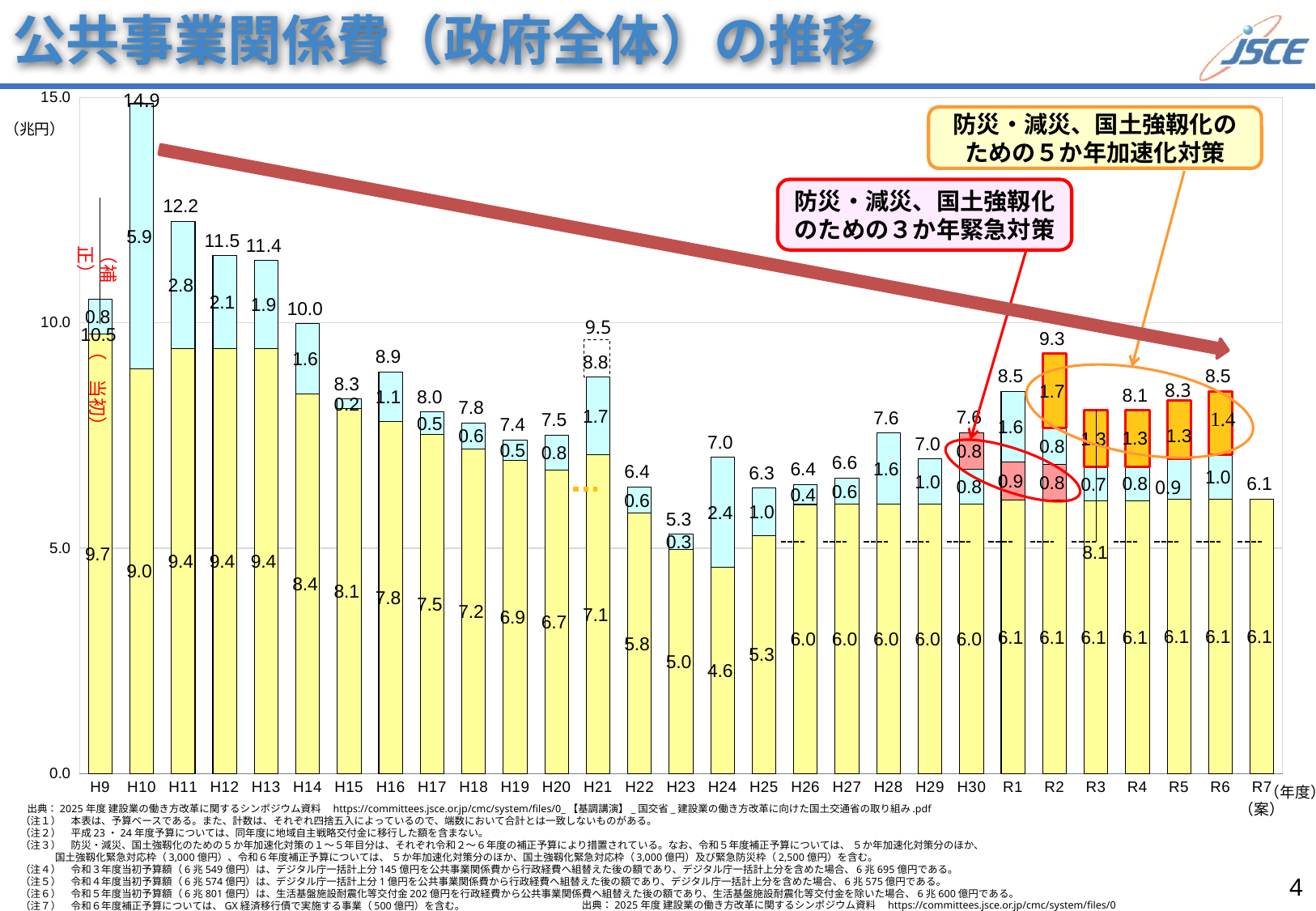
How many fiscal years are shown on the x axis? 29 What is the initial budget (yellow segment) value for H24? 4.6 Which fiscal year has the lowest total public works expenditure? H23 Is the total value for H22 greater or less than 10.0? less What is the total value labelled above the R2 bar? 9.3 What kind of chart is shown on the slide? stacked bar chart What unit is shown on the y axis of the chart? 兆円 What is the difference between the total for H10 (14.9) and the total for H23 (5.3)? 9.6 Which fiscal year has the highest total public works expenditure? H10 Do the total values generally rise or fall from H10 to H23? fall Which is larger, the total for R1 or the total for R3? R1 What is the total value labelled above the H10 bar? 14.9